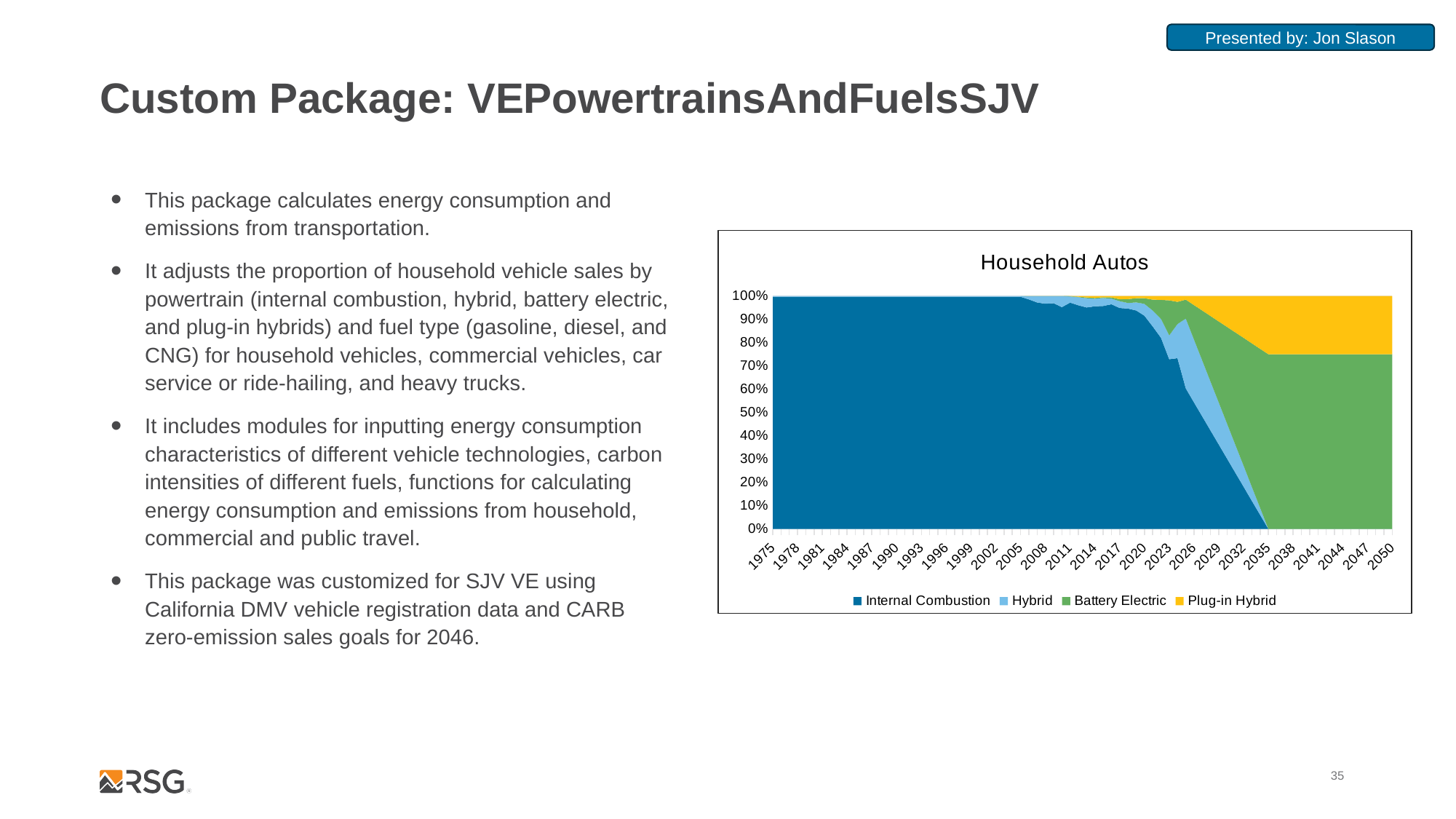
Is the Internal Combustion share in 2047 greater or less than 10%? less In 2050, which is larger: the Battery Electric share or the Plug-in Hybrid share? Battery Electric Does the Plug-in Hybrid share rise or fall from 2020 to 2050? Rise Does the Internal Combustion share rise or fall from 1975 to 2050? Fall What type of chart is shown on the slide? Stacked area chart Is the Internal Combustion share in 1990 greater or less than 90%? greater How many series does the chart legend list? 4 Which series has the largest share of household autos in 2050? Battery Electric Is the Battery Electric share in 2050 greater or less than 50%? greater Which series is shown in yellow in the chart? Plug-in Hybrid Which series has the largest share of household autos in 1975? Internal Combustion What is the title of the chart? Household Autos